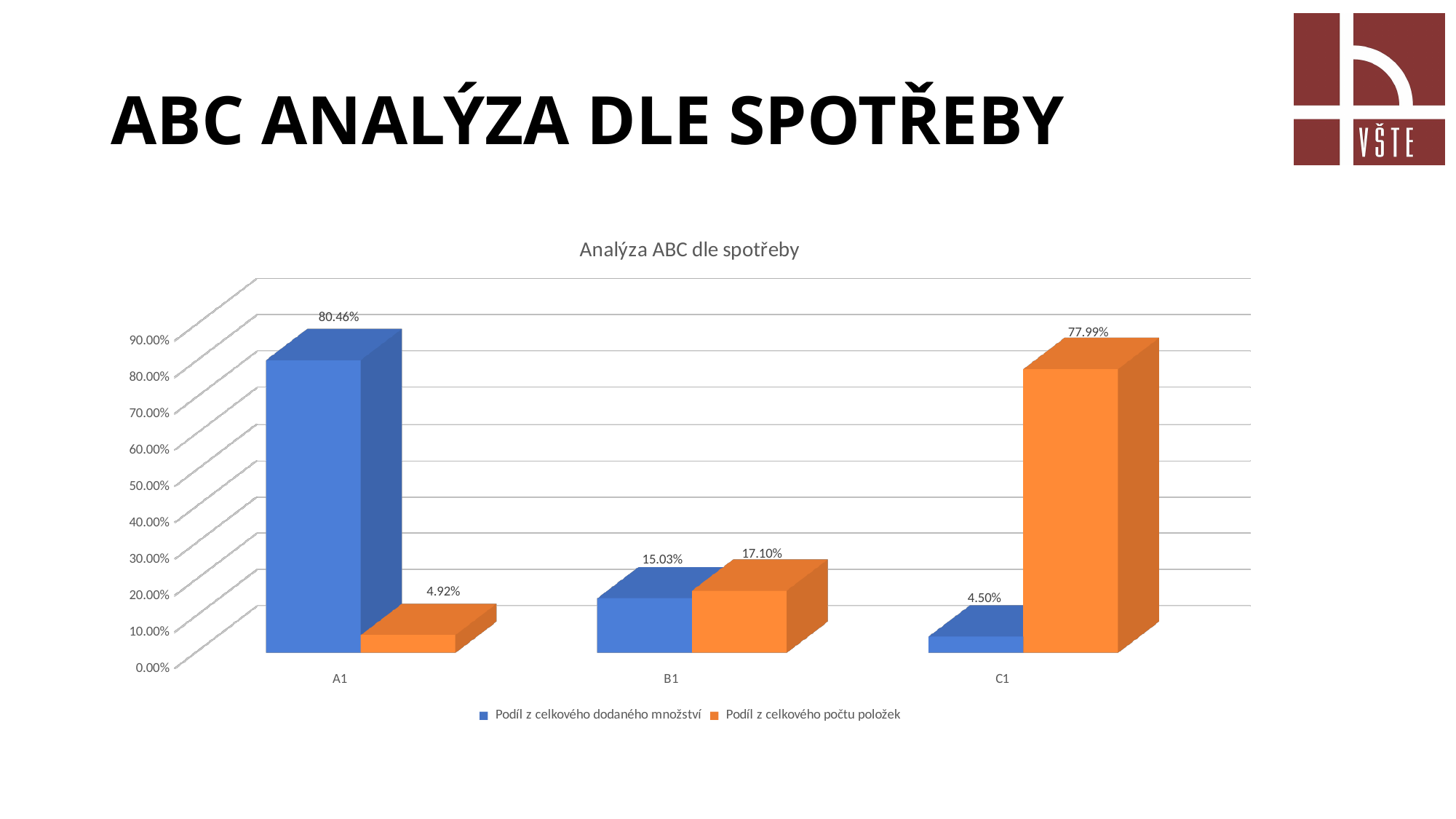
What kind of chart is shown? Bar chart Which category has the lowest value for 'Podíl z celkového počtu položek'? A1 For C1, which series has the larger value? Podíl z celkového počtu položek What is the value of 'Podíl z celkového dodaného množství' for C1? 4.50% What is the difference between the two series values for B1? 2.07% Which category has the highest value for 'Podíl z celkového dodaného množství'? A1 What is the title of the chart? Analýza ABC dle spotřeby What is the value of 'Podíl z celkového počtu položek' for C1? 77.99% How many series does the legend list? 2 What is the value of 'Podíl z celkového dodaného množství' for A1? 80.46% How many categories are shown on the x axis? 3 What is the value of 'Podíl z celkového počtu položek' for B1? 17.10%